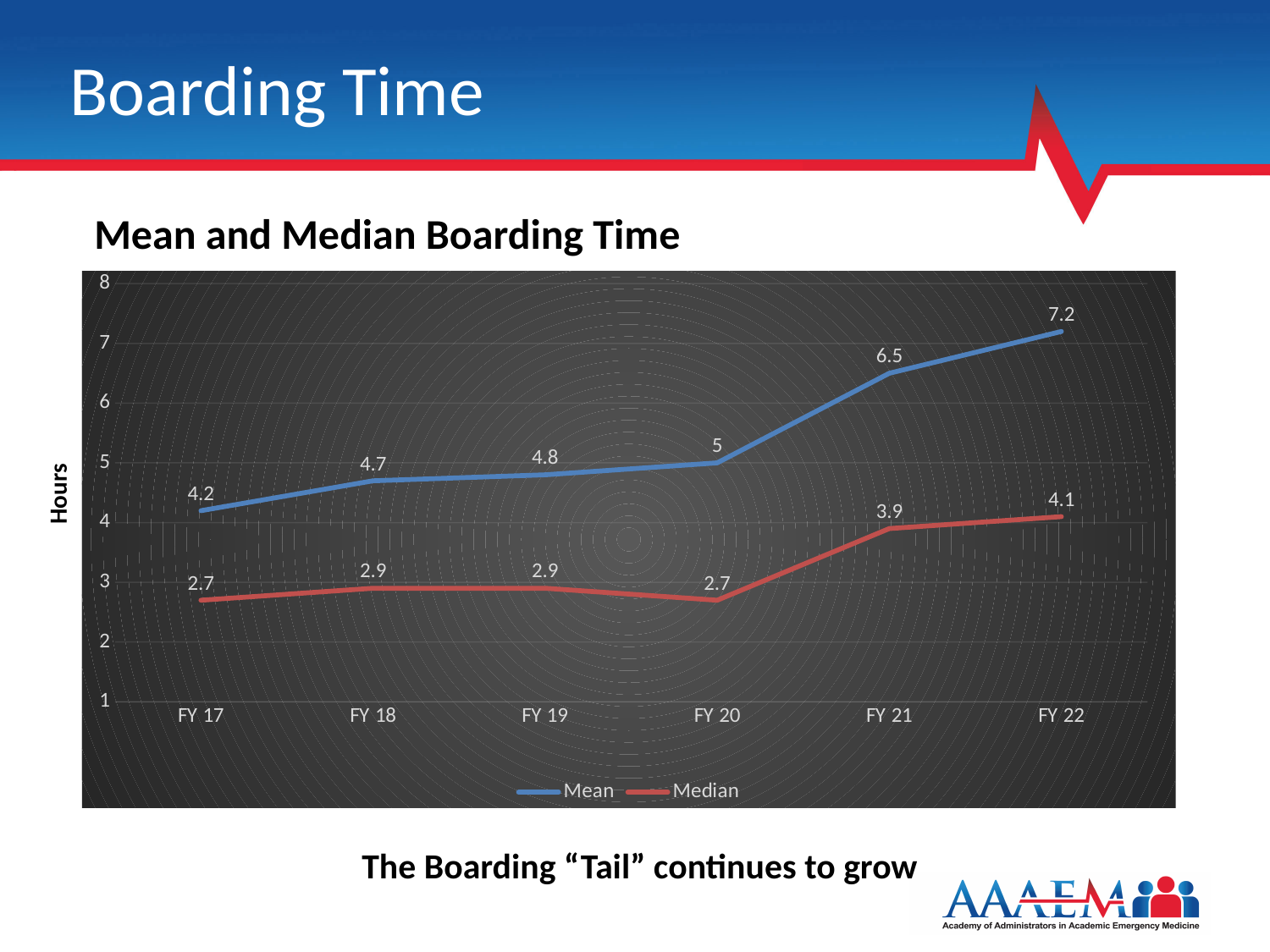
In which fiscal year is the Mean boarding time highest? FY 22 In which fiscal year is the Mean boarding time lowest? FY 17 Which is larger, the Median boarding time in FY 21 or in FY 20? FY 21 What is the difference between the Mean and Median boarding time in FY 22? 3.1 Does the Mean boarding time rise or fall from FY 17 to FY 22? Rise What kind of chart is shown on the slide? Line chart How many series does the legend list? 2 What is the Mean boarding time for FY 22? 7.2 How many fiscal years are shown on the x axis? 6 What is the Median boarding time for FY 19? 2.9 By how much did the Mean boarding time increase from FY 20 to FY 21? 1.5 What is the Mean boarding time for FY 17? 4.2